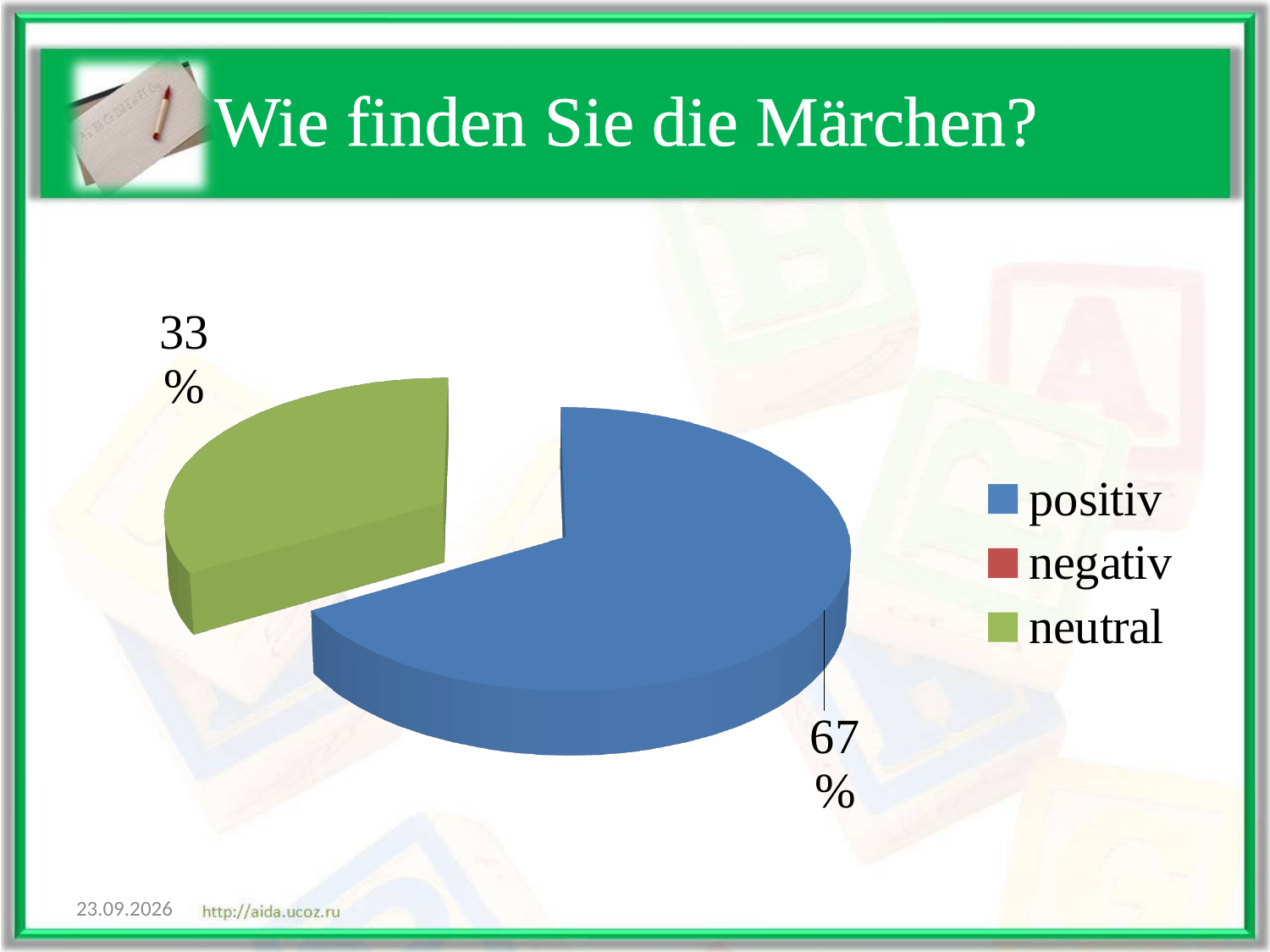
What is the title of the slide containing the chart? Wie finden Sie die Märchen? What is the difference in percentage points between the positiv and neutral slices? 34 What colour is the positiv slice in the pie chart? blue Is the share for positiv greater or less than 50%? greater How many slices are visible in the pie? 2 How many entries does the legend list? 3 Which legend entry has no visible slice in the pie? negativ What share of the pie is labelled for neutral? 33% What share of the pie is labelled for positiv? 67% Which category has the largest slice of the pie? positiv What kind of chart is shown on the slide? pie chart Which of the two visible slices is larger, positiv or neutral? positiv